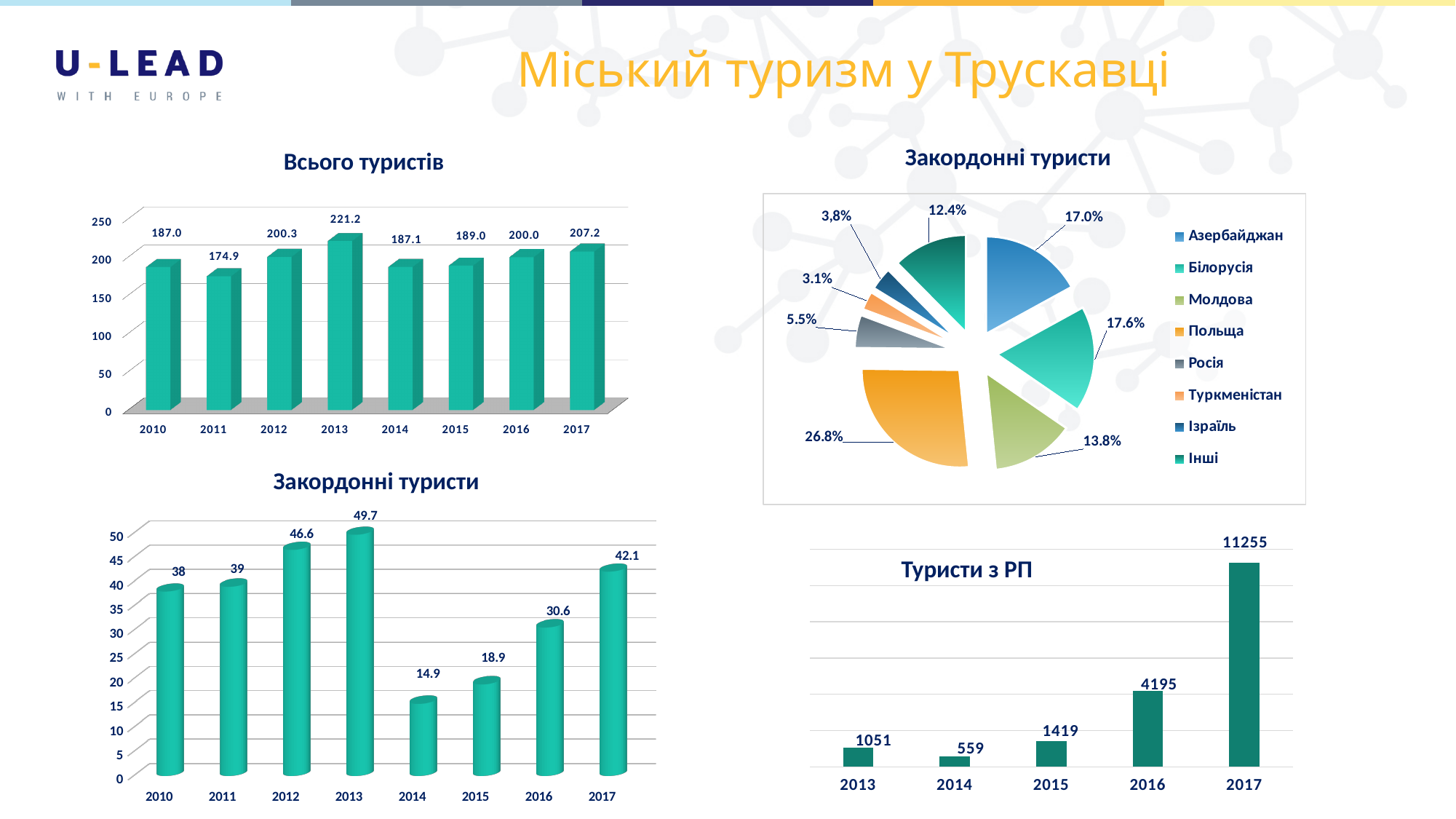
In the 'Закордонні туристи' pie chart, what share does Польща have? 26.8% How many years are shown in the 'Всього туристів' chart? 8 How many entries does the legend of the 'Закордонні туристи' pie chart list? 8 In the 'Туристи з РП' chart, what is the value for 2016? 4195 In the 'Туристи з РП' chart, what is the difference between the values for 2017 and 2016? 7060 In the 'Всього туристів' chart, what is the difference between the values for 2017 and 2010? 20.2 In the 'Всього туристів' chart, which year has the lowest value? 2011 In the 'Закордонні туристи' pie chart, which country has the smallest share? Туркменістан In the 'Закордонні туристи' bar chart at the bottom left, which year has the highest value? 2013 In the 'Закордонні туристи' bar chart at the bottom left, is the value for 2016 larger than the value for 2015? Yes, 2016 In the 'Всього туристів' chart, what is the value for 2013? 221.2 In the 'Закордонні туристи' bar chart at the bottom left, what is the value for 2014? 14.9